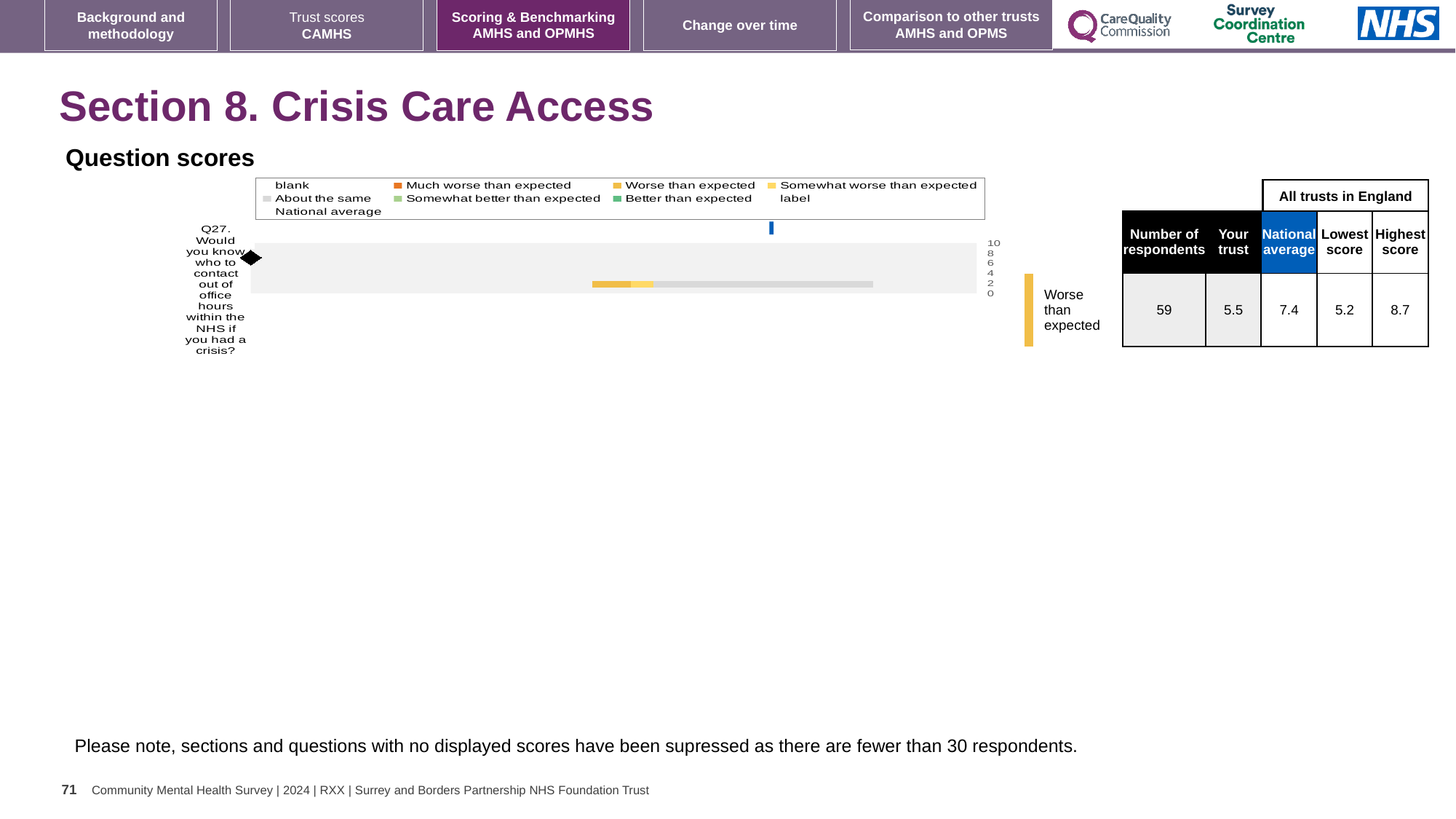
How many questions (categories) are plotted in the Question scores chart? 1 What benchmark category label is shown to the right of the Q27 bar? Worse than expected According to the table beside the chart, what is the 'Your trust' score for Q27? 5.5 According to the table beside the chart, what is the lowest score among all trusts in England for Q27? 5.2 What is the difference between the national average (7.4) and the trust's score (5.5) for Q27? 1.9 What kind of chart is shown under 'Question scores'? bar chart According to the table beside the chart, what is the national average score for Q27? 7.4 For Q27, which is larger: the trust's score or the national average? national average Is the trust's score for Q27 greater or less than 6 on the chart's axis? less According to the table beside the chart, how many respondents answered Q27? 59 Which question is plotted in the Question scores chart? Q27. Would you know who to contact out of office hours within the NHS if you had a crisis? According to the table beside the chart, what is the highest score among all trusts in England for Q27? 8.7